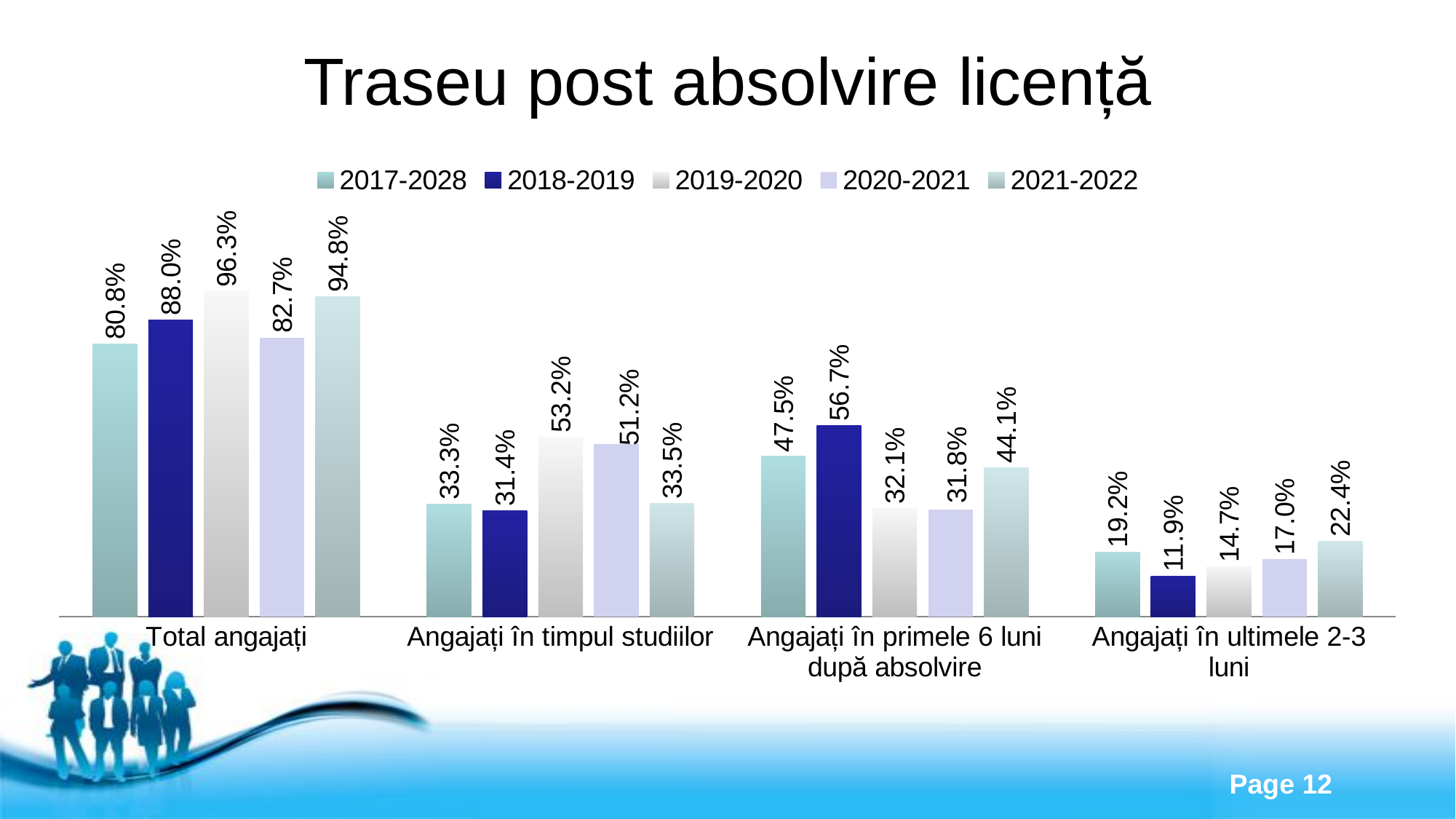
How many series does the legend list? 5 Which series has the highest value in the 'Total angajați' category? 2019-2020 What is the value for 2021-2022 in the 'Angajați în ultimele 2-3 luni' category? 22.4% How many categories are shown on the x axis? 4 What is the title of the slide containing the chart? Traseu post absolvire licență What kind of chart is shown on the slide? Bar chart What is the difference between the 2019-2020 and 2018-2019 values in the 'Angajați în timpul studiilor' category? 21.8% What is the value for 2018-2019 in the 'Angajați în primele 6 luni după absolvire' category? 56.7% Which series has the lowest value in the 'Angajați în ultimele 2-3 luni' category? 2018-2019 What is the value for 2020-2021 in the 'Angajați în timpul studiilor' category? 51.2% What is the value for 2019-2020 in the 'Total angajați' category? 96.3% In the 'Angajați în primele 6 luni după absolvire' category, which is larger: the 2017-2028 value or the 2021-2022 value? 2017-2028